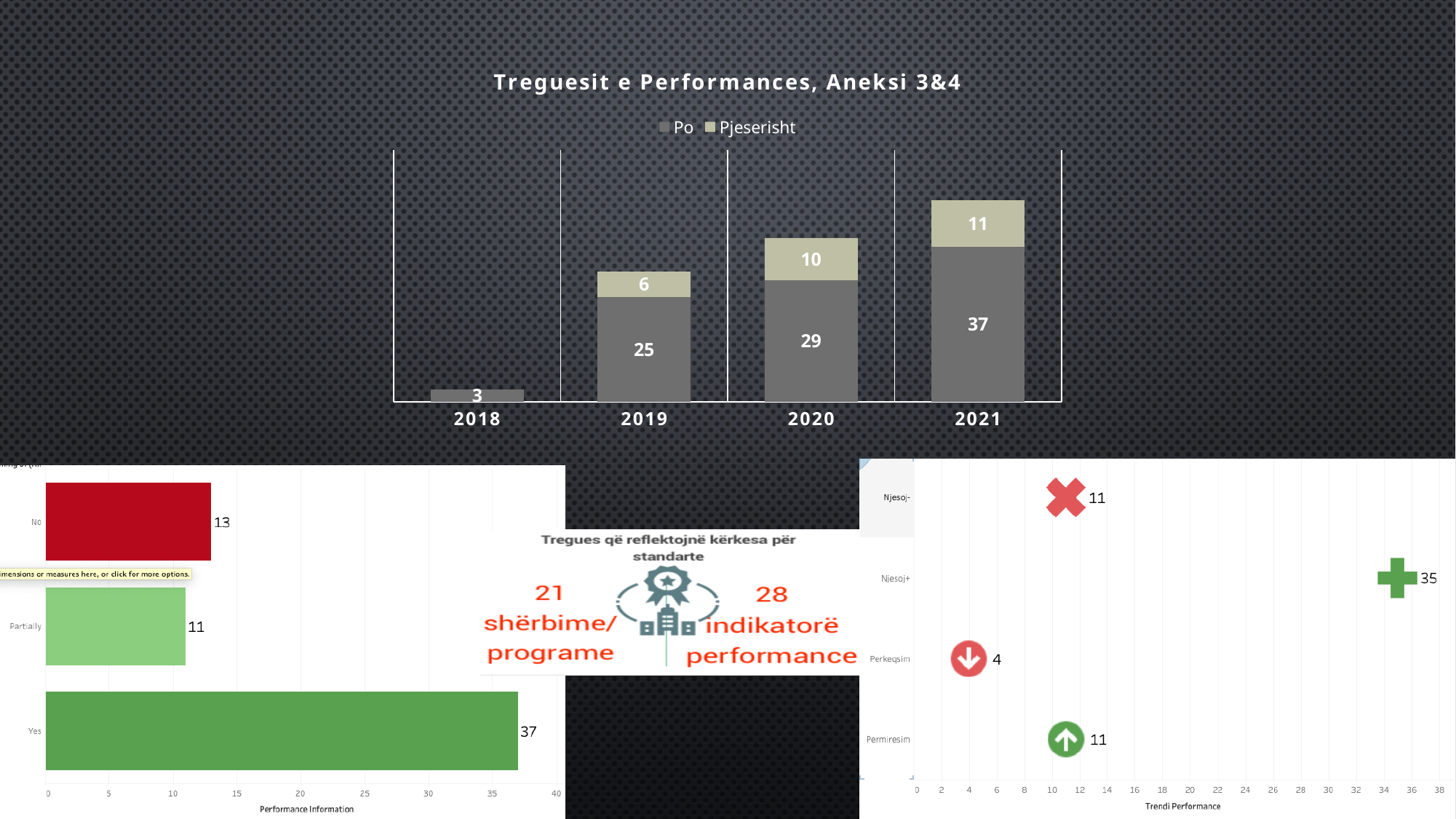
In the chart titled 'Treguesit e Performances, Aneksi 3&4', what is the value of the 'Pjeserisht' series for 2020? 10 What kind of chart is the bottom-left chart labelled 'Performance Information'? bar chart In the chart titled 'Treguesit e Performances, Aneksi 3&4', which year has the lowest 'Po' value? 2018 In the bottom-left chart labelled 'Performance Information', what is the value for 'Yes'? 37 In the bottom-right chart labelled 'Trendi Performance', what is the value for 'Njesoj+'? 35 In the chart titled 'Treguesit e Performances, Aneksi 3&4', what is the difference between the 'Po' values for 2021 and 2020? 8 In the chart titled 'Treguesit e Performances, Aneksi 3&4', what is the total of the stacked bar for 2019? 31 In the bottom-left chart labelled 'Performance Information', which category has the lowest value? Partially In the chart titled 'Treguesit e Performances, Aneksi 3&4', does the 'Po' value rise or fall from 2018 to 2021? rise In the chart titled 'Treguesit e Performances, Aneksi 3&4', what is the value of the 'Po' series for 2021? 37 In the chart titled 'Treguesit e Performances, Aneksi 3&4', how many series does the legend list? 2 In the bottom-right chart labelled 'Trendi Performance', which category has the lowest value? Perkeqsim